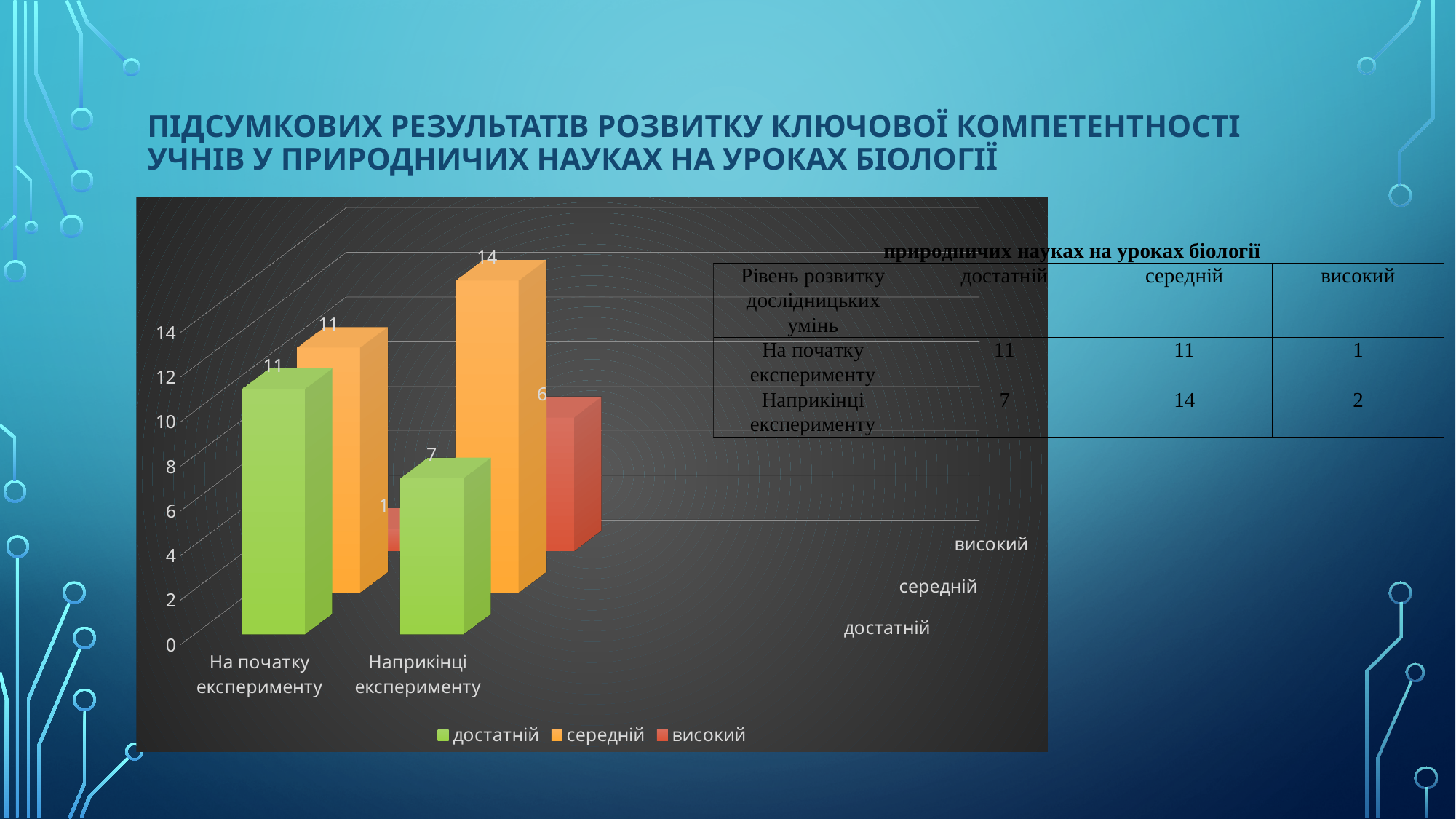
By how much does the середній value at Наприкінці експерименту exceed the середній value at На початку експерименту? 3 What is the value for середній at Наприкінці експерименту? 14 How many categories are shown along the x axis of the chart? 2 How many series does the chart legend list? 3 What is the value for достатній at Наприкінці експерименту? 7 Which series has the highest value at Наприкінці експерименту? середній Which is larger: the достатній value at На початку експерименту or at Наприкінці експерименту? На початку експерименту What is the value for достатній at На початку експерименту? 11 What is the value for високий at На початку експерименту? 1 What is the difference between the достатній values at На початку експерименту and Наприкінці експерименту? 4 Does the достатній series rise or fall from На початку експерименту to Наприкінці експерименту? fall What kind of chart is shown on the slide? bar chart